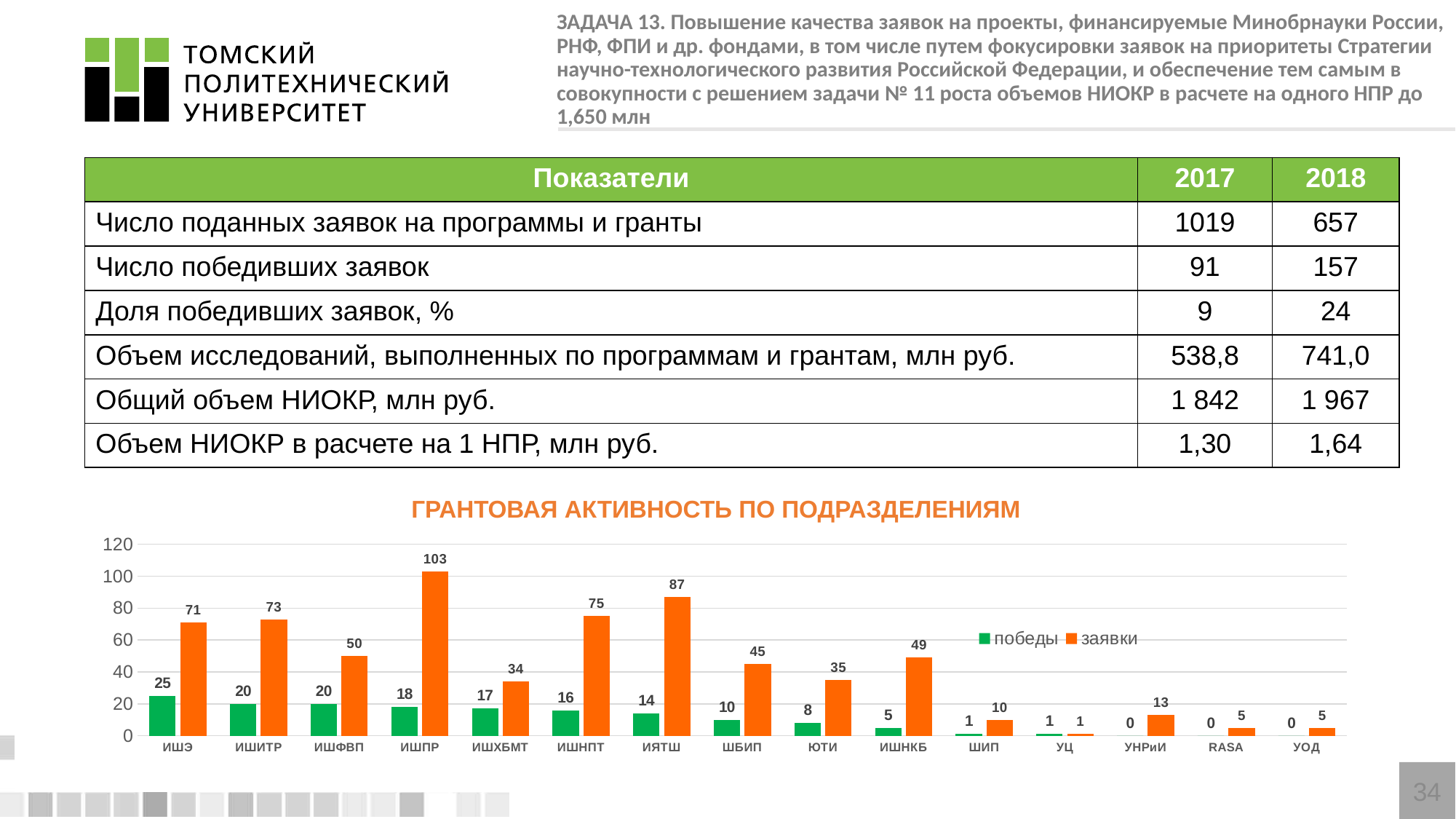
What is the value of 'заявки' for ИШПР? 103 Which category has the highest value of 'победы'? ИШЭ How many series does the legend of the chart list? 2 Which colour represents the 'победы' series in the chart? green What is the value of 'победы' for ИШЭ? 25 What is the difference between 'заявки' and 'победы' for ИЯТШ? 73 How many categories (подразделения) are shown on the x axis of the chart? 15 Is the value of 'заявки' for ИШИТР greater or less than 60? greater Which is larger: 'заявки' for ИШНПТ or 'заявки' for ИШФВП? ИШНПТ What type of chart is shown under the title 'ГРАНТОВАЯ АКТИВНОСТЬ ПО ПОДРАЗДЕЛЕНИЯМ'? bar chart What is the value of 'заявки' for УНРиИ? 13 Which category has the highest value of 'заявки'? ИШПР